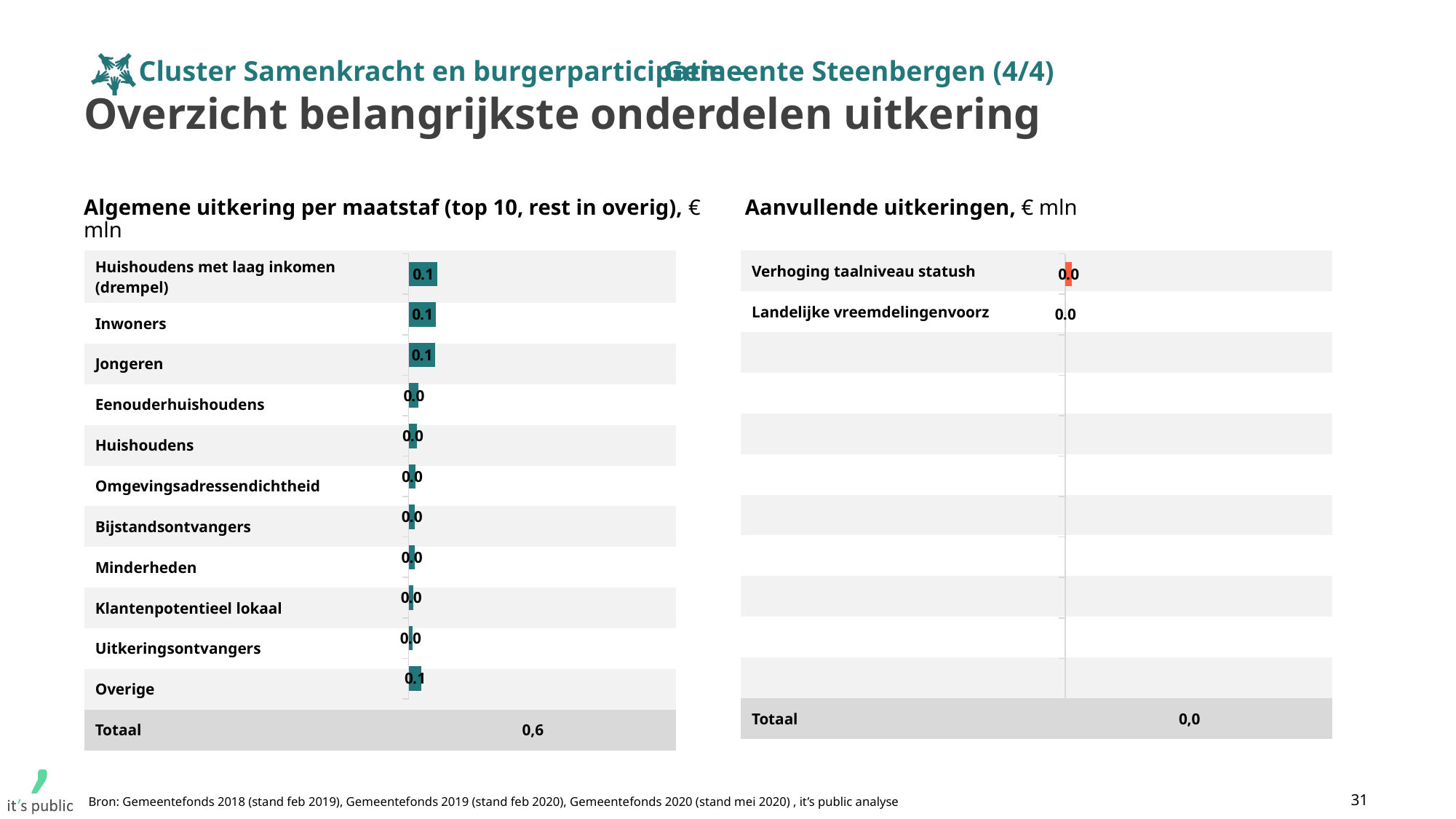
In the chart 'Algemene uitkering per maatstaf', what is the value for Bijstandsontvangers? 0.0 In the chart 'Algemene uitkering per maatstaf', what is the value for Inwoners? 0.1 In the chart 'Algemene uitkering per maatstaf', what is the Totaal shown at the bottom? 0,6 What kind of chart is 'Algemene uitkering per maatstaf'? Bar chart In the chart 'Aanvullende uitkeringen', what is the value for Verhoging taalniveau statush? 0.0 In the chart 'Aanvullende uitkeringen', what is the Totaal shown at the bottom? 0,0 In the chart 'Algemene uitkering per maatstaf', what is the value for Jongeren? 0.1 In the chart 'Algemene uitkering per maatstaf', what is the value for Overige? 0.1 In the chart 'Aanvullende uitkeringen', how many categories are listed (excluding Totaal)? 2 In the chart 'Algemene uitkering per maatstaf', how many categories are listed (including Overige, excluding Totaal)? 11 In the chart 'Algemene uitkering per maatstaf', what is the difference between the value for Inwoners and the value for Minderheden? 0.1 In the chart 'Algemene uitkering per maatstaf', which is larger: Huishoudens met laag inkomen (drempel) or Eenouderhuishoudens? Huishoudens met laag inkomen (drempel)